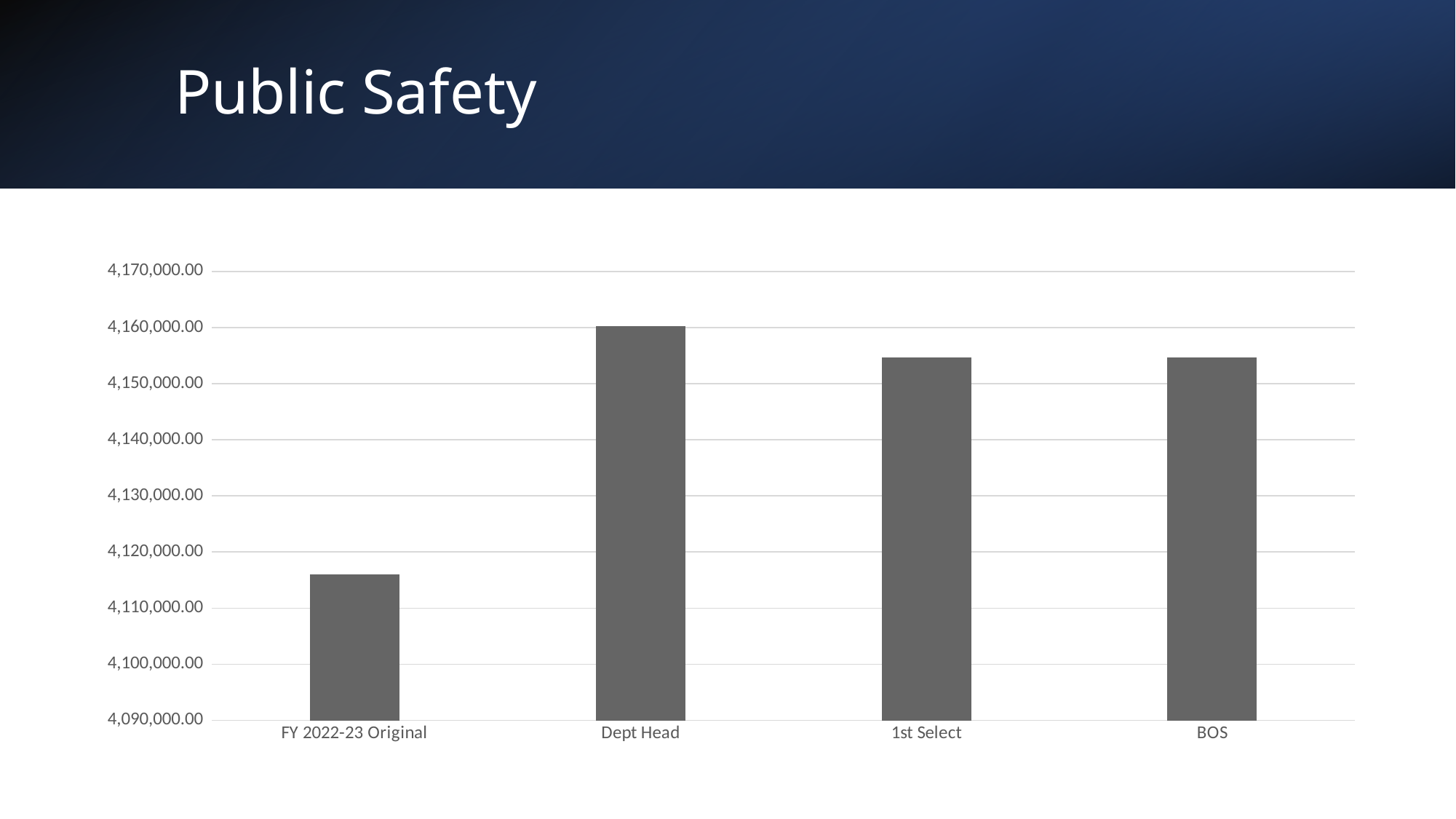
Which category has the highest value? Dept Head Which is larger, the value for FY 2022-23 Original or the value for BOS? BOS What is the title of the slide containing the chart? Public Safety Which category has the lowest value? FY 2022-23 Original Which is larger, the value for Dept Head or the value for 1st Select? Dept Head Is the value for Dept Head greater or less than 4,150,000.00? greater Is the value for 1st Select greater or less than 4,150,000.00? greater How many categories are plotted on the chart? 4 Is the value for BOS greater or less than 4,160,000.00? less What is the lowest value shown on the vertical axis? 4,090,000.00 What kind of chart is shown on the slide? bar chart